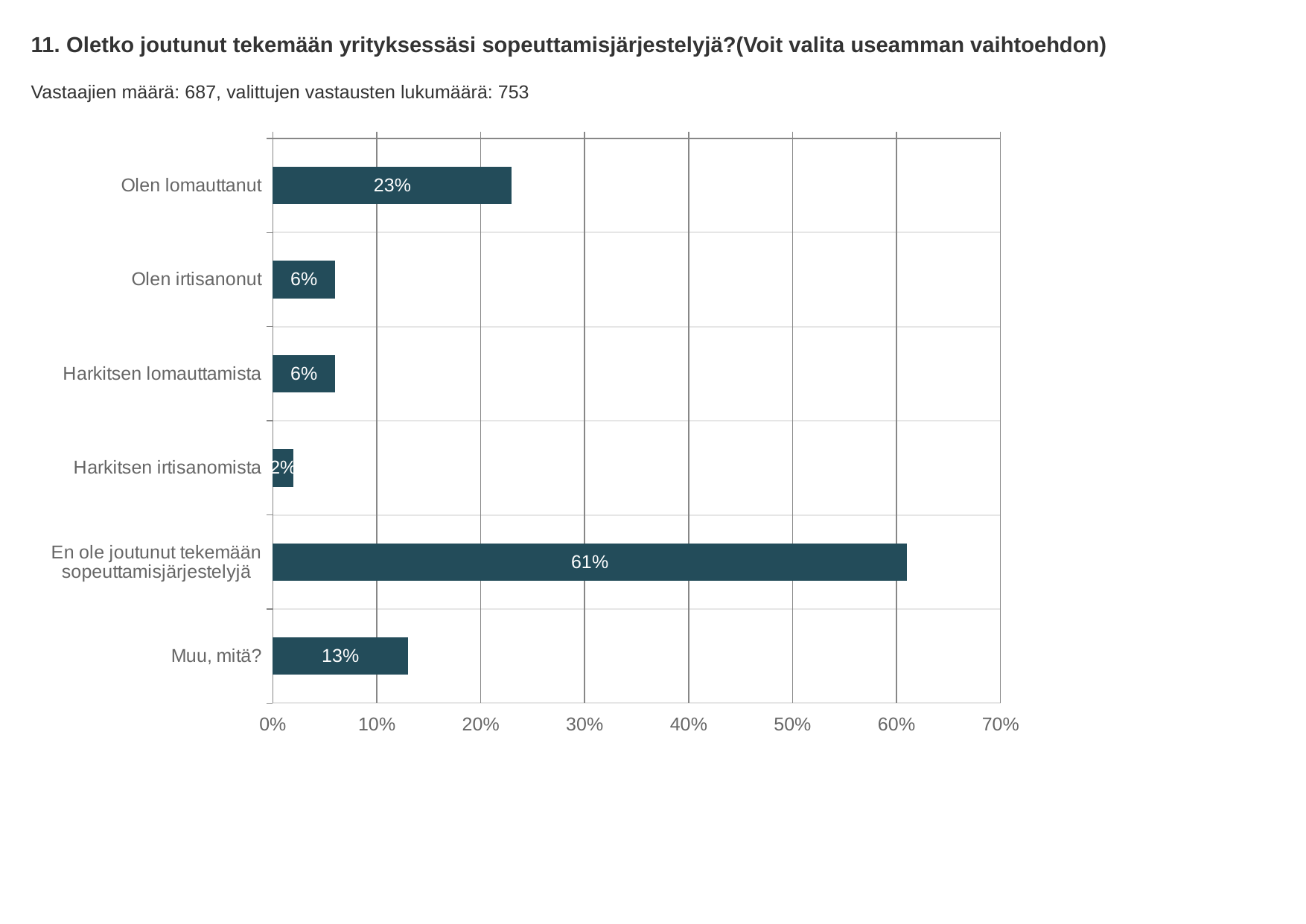
What kind of chart is shown on the slide? Bar chart Which is larger, the value for "Olen lomauttanut" or the value for "Muu, mitä?"? Olen lomauttanut Is the value for "En ole joutunut tekemään sopeuttamisjärjestelyjä" greater or less than 50%? greater Which category has the lowest value? Harkitsen irtisanomista What is the difference between the values for "En ole joutunut tekemään sopeuttamisjärjestelyjä" and "Olen lomauttanut"? 38% What is the value for "Muu, mitä?"? 13% Which category has the highest value? En ole joutunut tekemään sopeuttamisjärjestelyjä What is the difference between the values for "Olen lomauttanut" and "Muu, mitä?"? 10% What is the value for "En ole joutunut tekemään sopeuttamisjärjestelyjä"? 61% How many categories are shown in the chart? 6 What is the value for "Olen lomauttanut"? 23% What is the value for "Harkitsen irtisanomista"? 2%